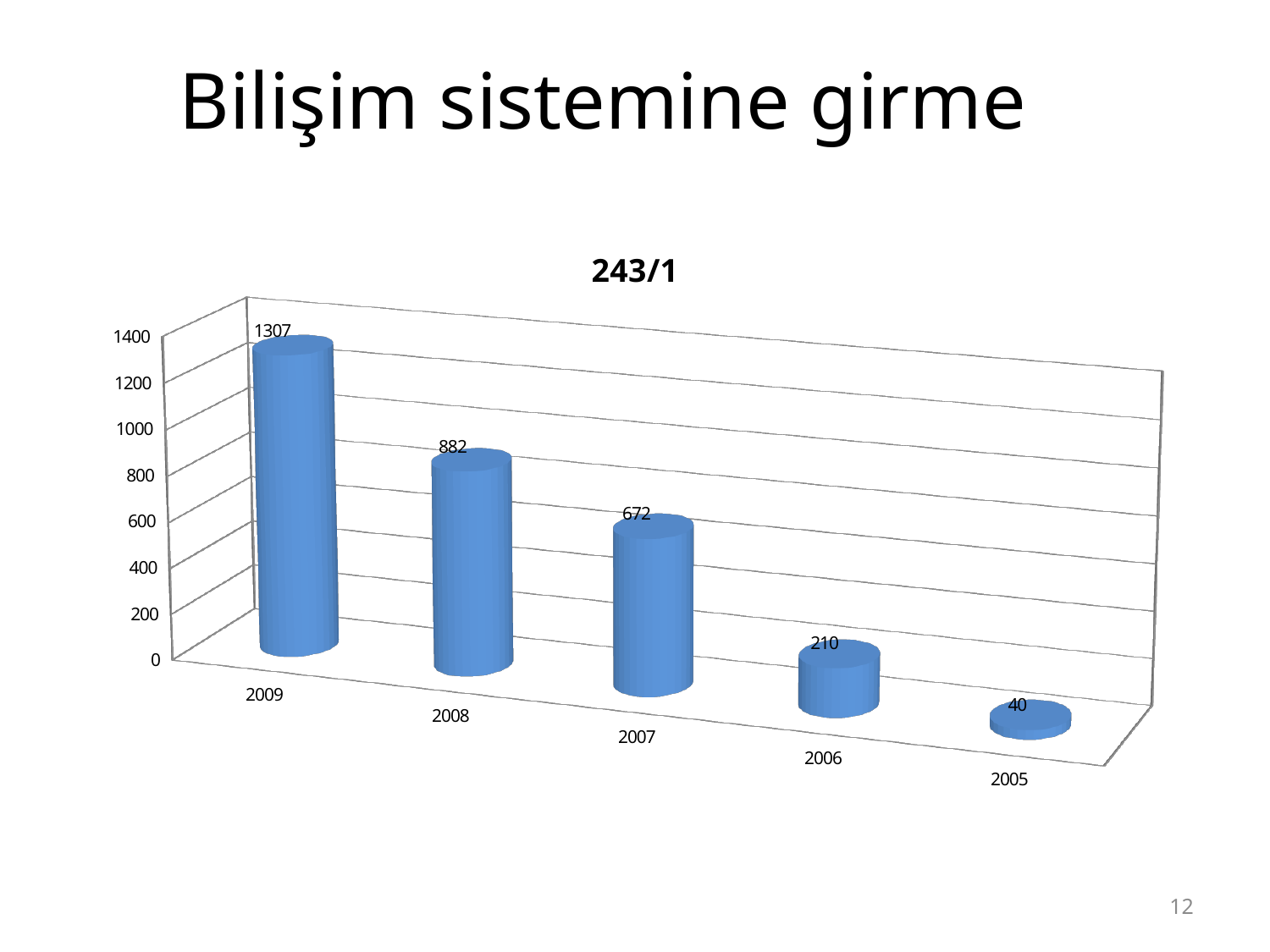
How many years are shown on the chart? 5 What is the value for 2007? 672 What is the title of the chart? 243/1 What is the difference between the values for 2006 and 2005? 170 Which year has the lowest value? 2005 Which is larger, the value for 2008 or the value for 2007? 2008 Which year has the highest value? 2009 What is the difference between the values for 2009 and 2008? 425 What is the value for 2009? 1307 What is the value for 2005? 40 What kind of chart is shown on the slide? bar chart Is the value for 2006 greater or less than 400? less